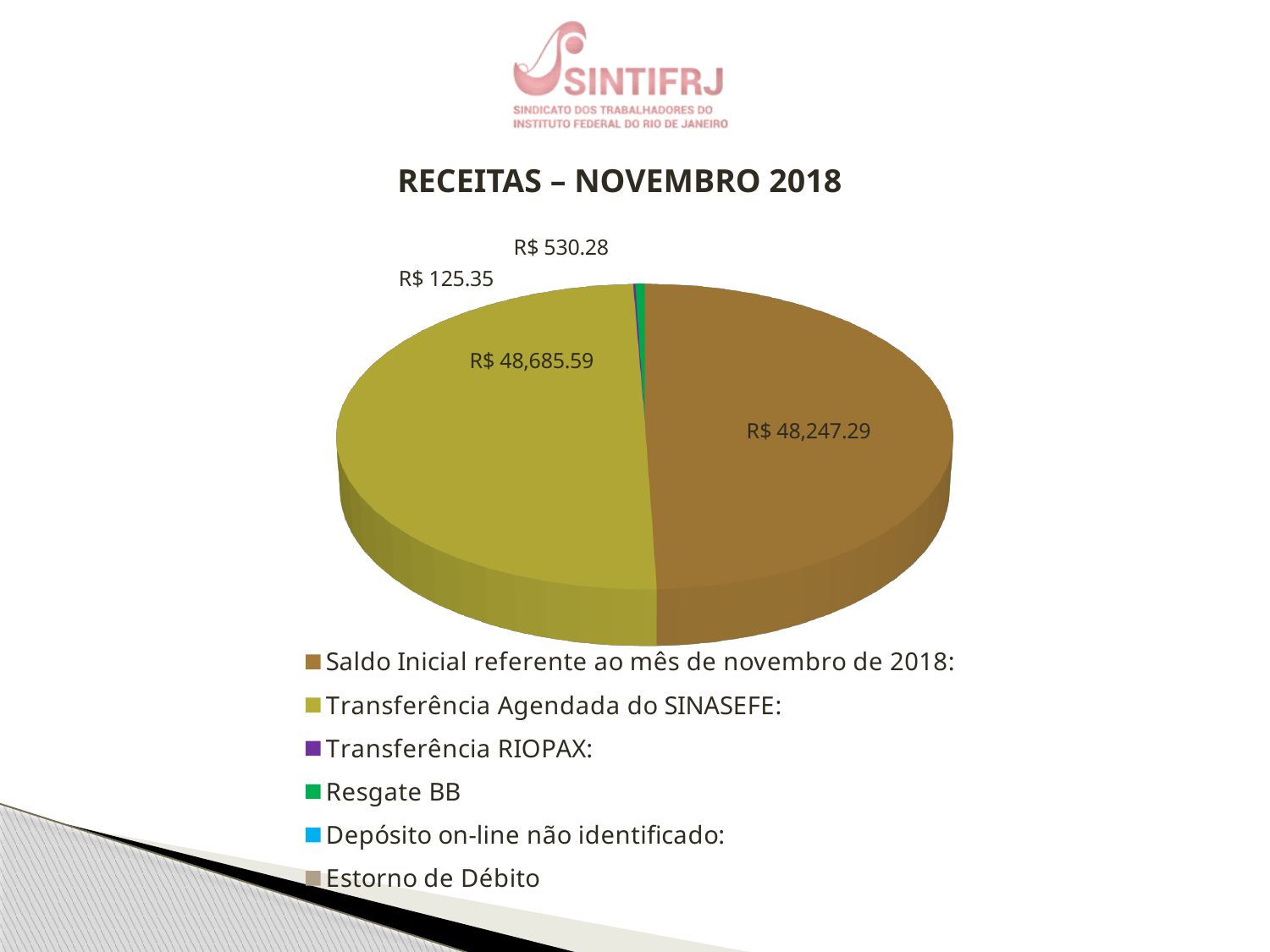
What is the value for "Saldo Inicial referente ao mês de novembro de 2018"? R$ 48,247.29 What kind of chart is shown on the slide? pie chart What is the value for "Resgate BB"? R$ 530.28 Which category has the largest value? Transferência Agendada do SINASEFE Which is larger, the value for "Transferência RIOPAX" or the value for "Resgate BB"? Resgate BB Which legend entry is shown in green? Resgate BB How many categories does the legend list? 6 What is the title of the chart? RECEITAS – NOVEMBRO 2018 What is the difference between the value for "Resgate BB" and the value for "Transferência RIOPAX"? R$ 404.93 What is the value for "Transferência RIOPAX"? R$ 125.35 What is the difference between the value for "Transferência Agendada do SINASEFE" and the value for "Saldo Inicial referente ao mês de novembro de 2018"? R$ 438.30 What is the value for "Transferência Agendada do SINASEFE"? R$ 48,685.59